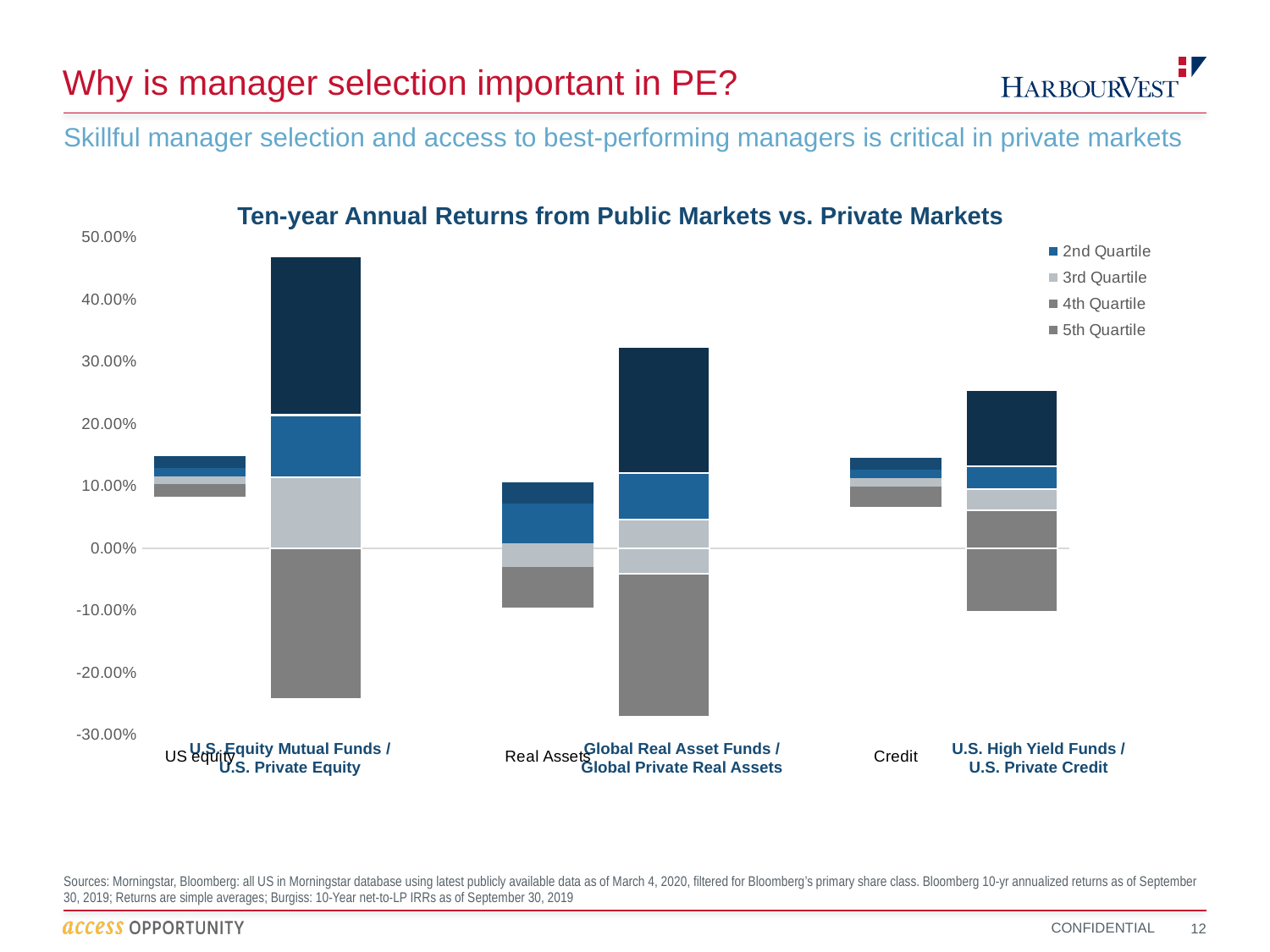
How many series does the chart legend list? 4 Is the bottom of the U.S. Private Equity bar greater or less than -20.00%? less Is the top of the U.S. Private Credit bar greater or less than 20.00%? greater Which bar reaches the highest value on the chart? U.S. Private Equity Is the top of the U.S. Private Equity bar greater or less than 40.00%? greater Which entries appear in the chart legend? 2nd Quartile, 3rd Quartile, 4th Quartile, 5th Quartile Which bar reaches higher, U.S. Private Equity or Global Private Real Assets? U.S. Private Equity What is the title of the chart? Ten-year Annual Returns from Public Markets vs. Private Markets What kind of chart is shown on the slide? Stacked bar chart How many category labels are shown along the x axis of the chart? 3